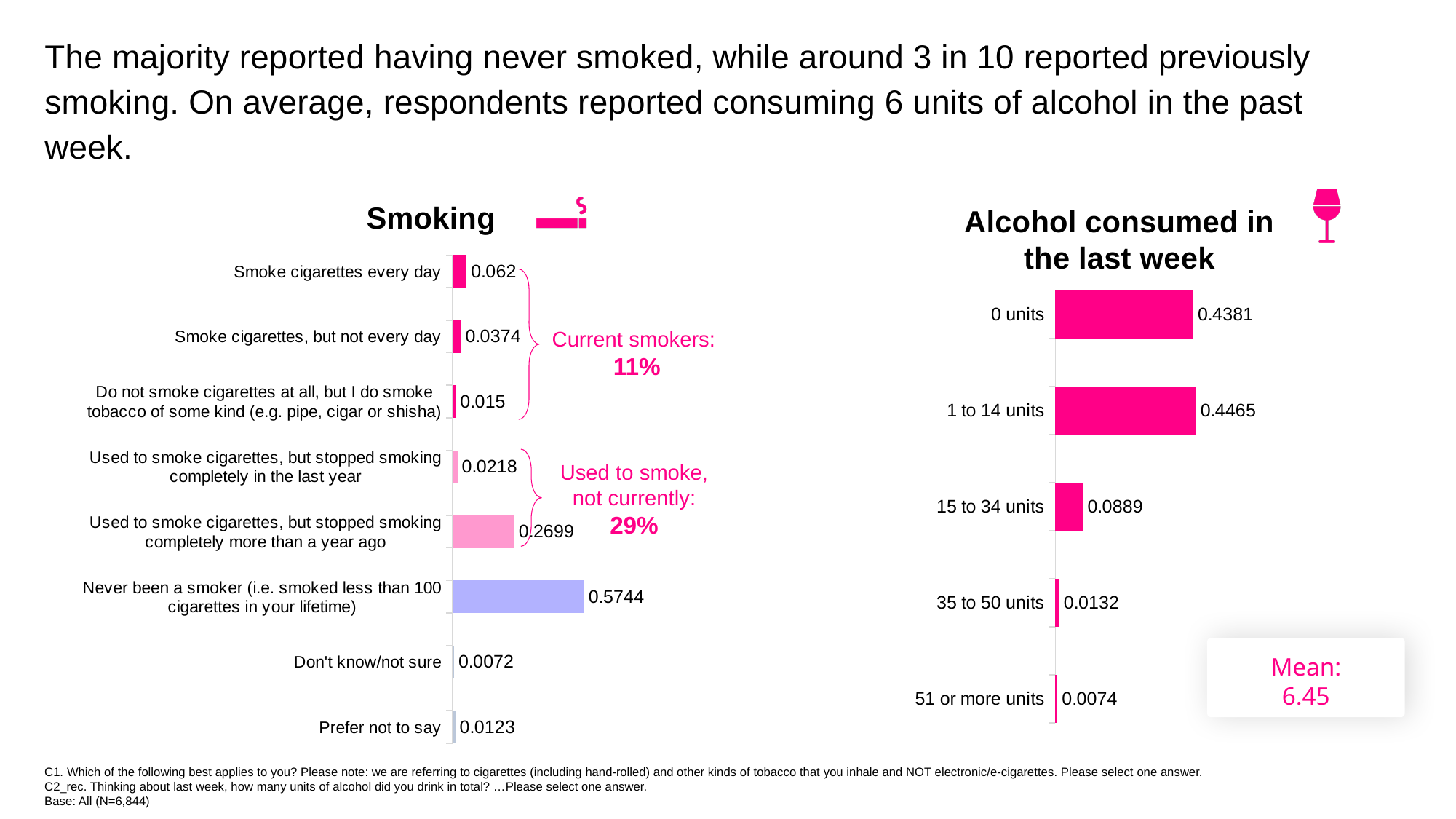
In the Smoking chart, which category has the lowest value? Don't know/not sure In the Smoking chart, what is the value for 'Smoke cigarettes every day'? 0.062 In the Smoking chart, which is larger: 'Smoke cigarettes, but not every day' or 'Prefer not to say'? Smoke cigarettes, but not every day How many categories are shown in the Smoking chart? 8 In the 'Alcohol consumed in the last week' chart, which category has the highest value? 1 to 14 units How many categories are shown in the 'Alcohol consumed in the last week' chart? 5 What type of chart is the 'Alcohol consumed in the last week' chart? Bar chart What mean value is shown next to the 'Alcohol consumed in the last week' chart? 6.45 In the Smoking chart, what is the value for 'Never been a smoker (i.e. smoked less than 100 cigarettes in your lifetime)'? 0.5744 In the Smoking chart, what is the difference between 'Used to smoke cigarettes, but stopped smoking completely more than a year ago' and 'Used to smoke cigarettes, but stopped smoking completely in the last year'? 0.2481 In the 'Alcohol consumed in the last week' chart, what is the difference between '1 to 14 units' and '0 units'? 0.0084 In the 'Alcohol consumed in the last week' chart, what is the value for '15 to 34 units'? 0.0889